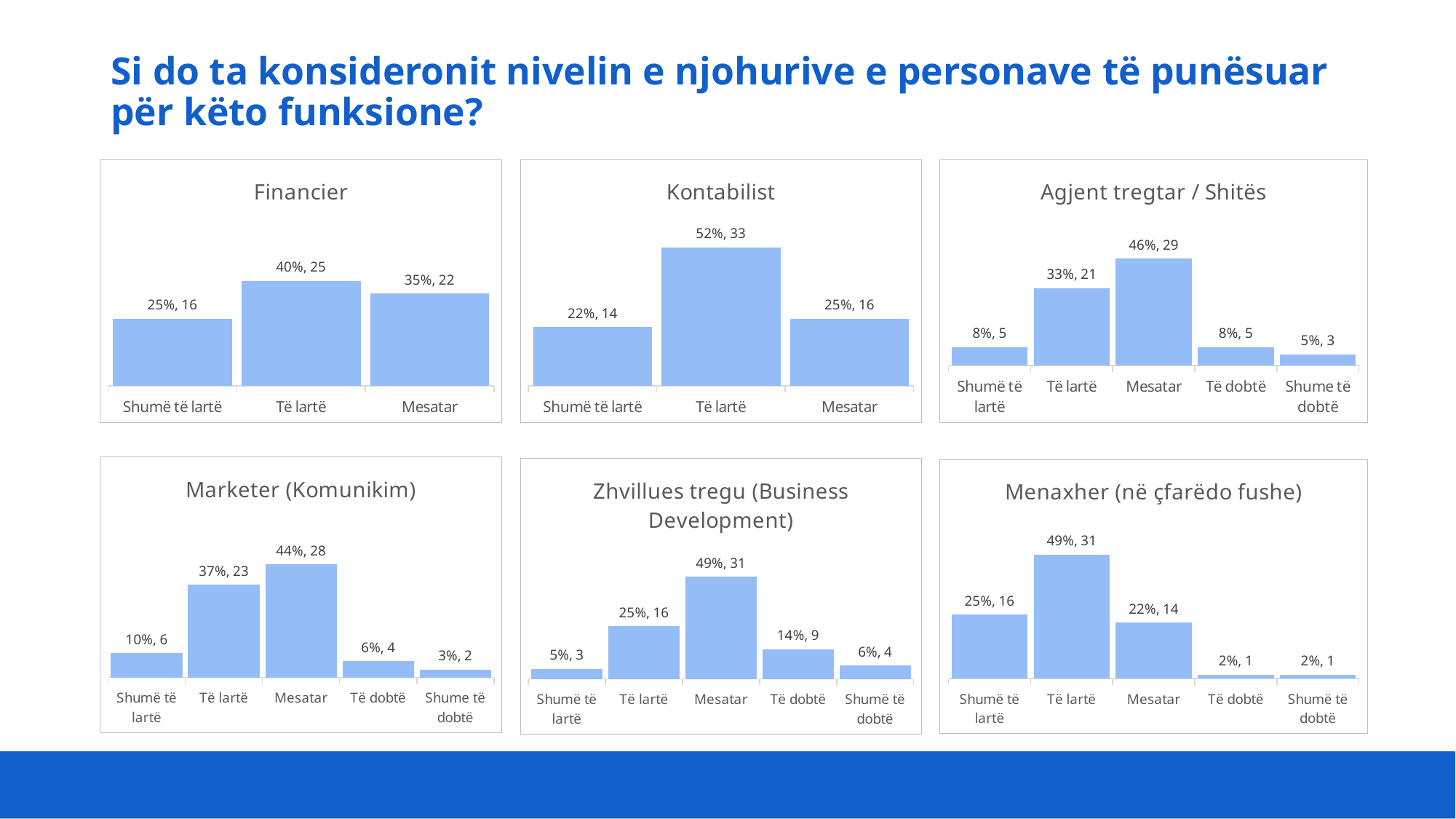
In the Agjent tregtar / Shitës chart, what is the data label for Mesatar? 46%, 29 In the Financier chart, what is the data label for Të lartë? 40%, 25 In the Marketer (Komunikim) chart, what is the data label for Mesatar? 44%, 28 In the Kontabilist chart, what is the data label for Shumë të lartë? 22%, 14 In the Menaxher (në çfarëdo fushe) chart, what is the difference in count between Të lartë and Mesatar? 17 What kind of chart is the Marketer (Komunikim) chart? Bar chart In the Financier chart, which is larger, Shumë të lartë or Mesatar? Mesatar In the Agjent tregtar / Shitës chart, which category has the lowest value? Shume të dobtë How many charts are on the slide? 6 In the Zhvillues tregu (Business Development) chart, how many categories are shown on the x axis? 5 In the Zhvillues tregu (Business Development) chart, what is the difference in percentage between Mesatar and Të dobtë? 35% In the Kontabilist chart, which category has the highest value? Të lartë